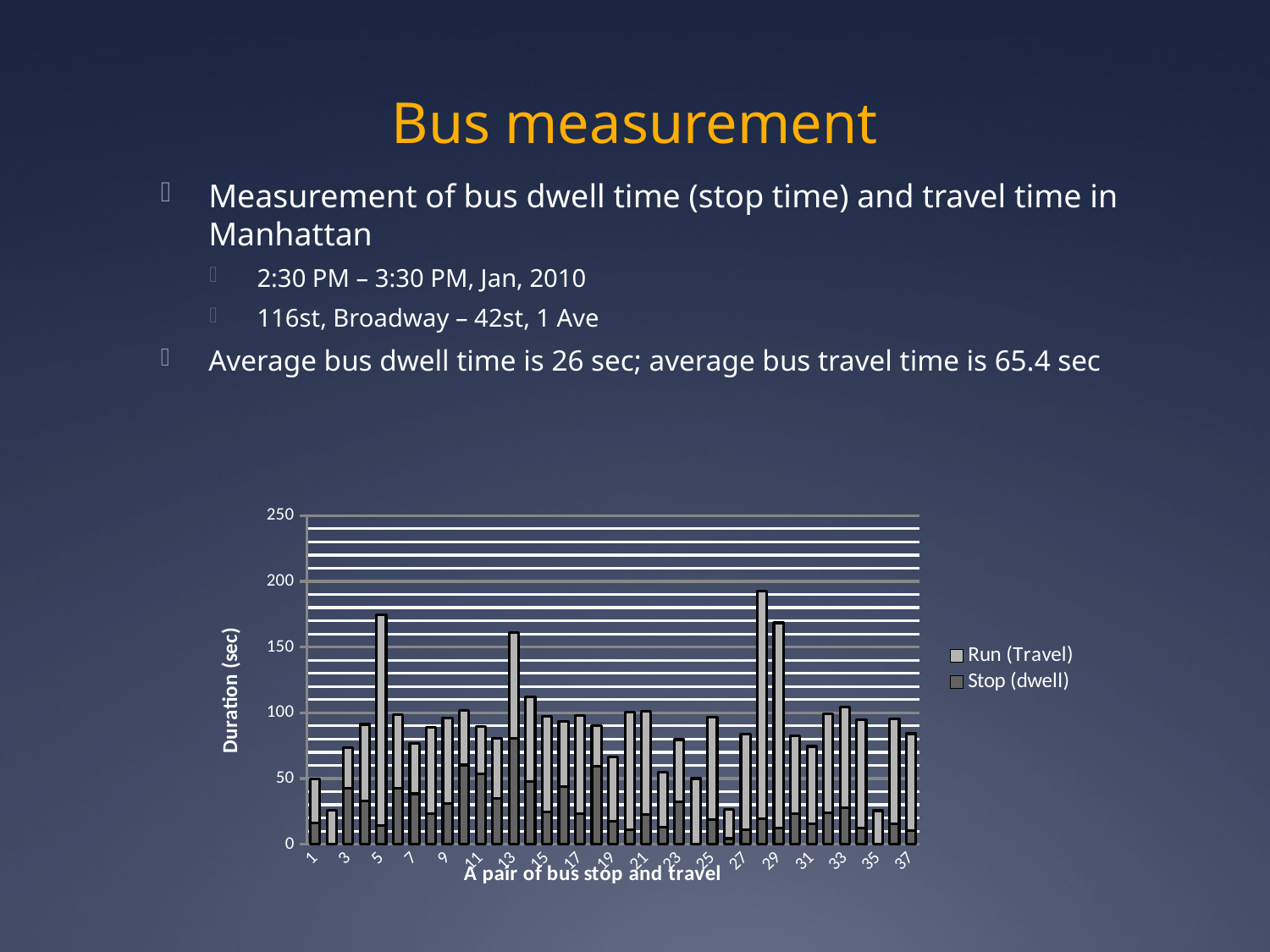
Is the total duration for pair 26 greater or less than 50? less Is the total duration for pair 13 greater or less than 150? greater Is the total duration for pair 28 greater or less than 150? greater How many series does the chart legend list? 2 What are the two series named in the chart legend? Run (Travel) and Stop (dwell) Which has a larger total duration, pair 28 or pair 5? 28 Which bus stop/travel pair has the tallest stacked bar in the chart? 28 What kind of chart is shown on the slide? Stacked bar chart What is the title of the vertical axis of the chart? Duration (sec) Which has a larger total duration, pair 5 or pair 13? 5